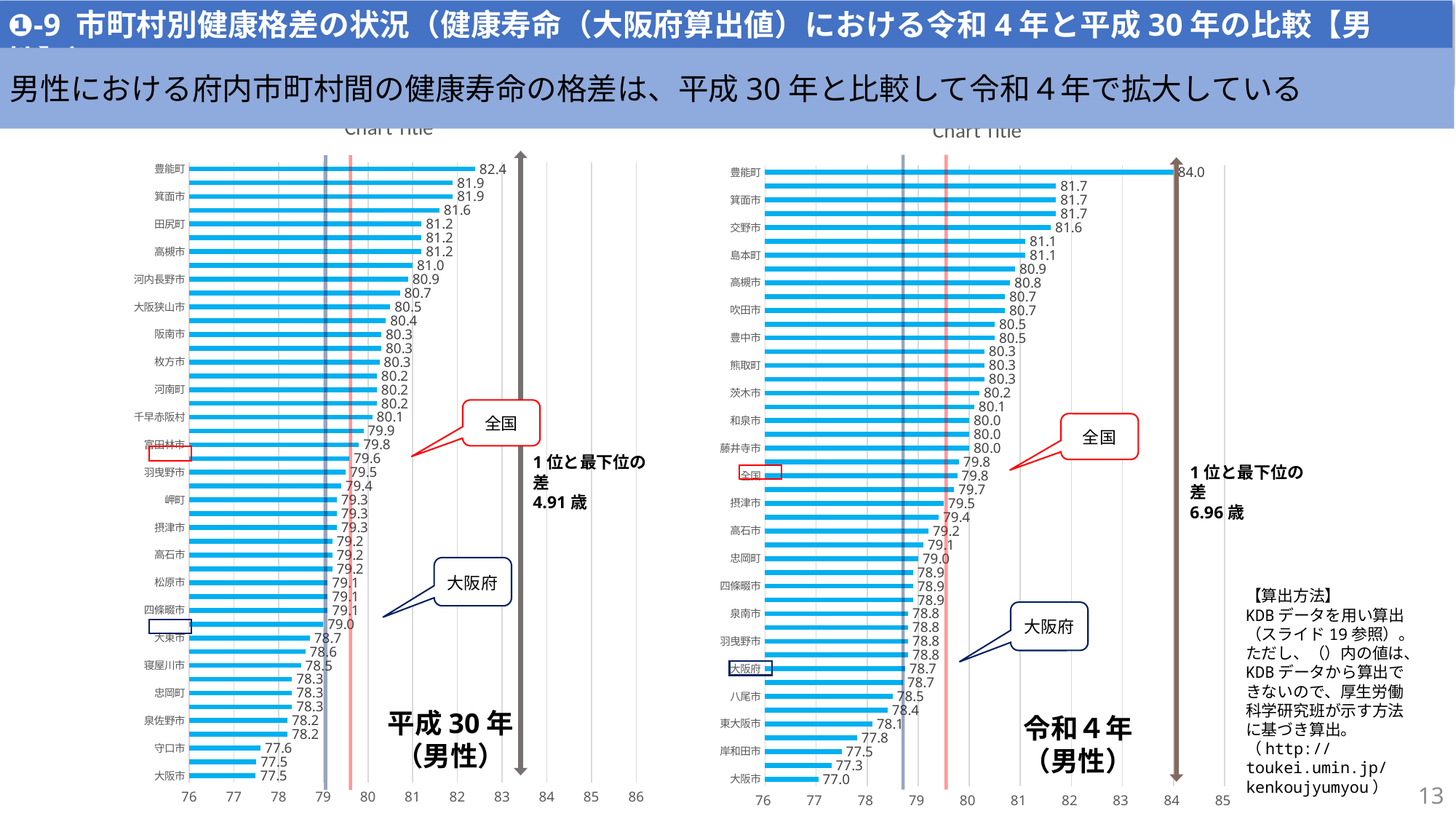
In the 令和4年（男性） chart on the right, which municipality has the highest value? 豊能町 What is the difference between the value for 豊能町 in the 令和4年 chart (84.0) and in the 平成30年 chart (82.4)? 1.6 In the 令和4年（男性） chart on the right, what is the value for 豊能町? 84.0 In the 平成30年（男性） chart on the left, which municipality has the lowest value? 大阪市 In the 平成30年（男性） chart on the left, what is the value for 豊能町? 82.4 In the 令和4年（男性） chart on the right, what is the value for 大阪市? 77.0 In the 平成30年（男性） chart on the left, is the value for 守口市 greater or less than 78? less In the 平成30年（男性） chart on the left, what is the value for 大阪府? 79.0 What kind of chart is the 令和4年（男性） chart on the right? bar chart According to the annotation on the 令和4年（男性） chart on the right, what is the gap between first and last place (1位と最下位の差)? 6.96歳 In the 令和4年（男性） chart on the right, which is larger, the value for 交野市 or the value for 高槻市? 交野市 In the 令和4年（男性） chart on the right, what is the value for 全国? 79.8